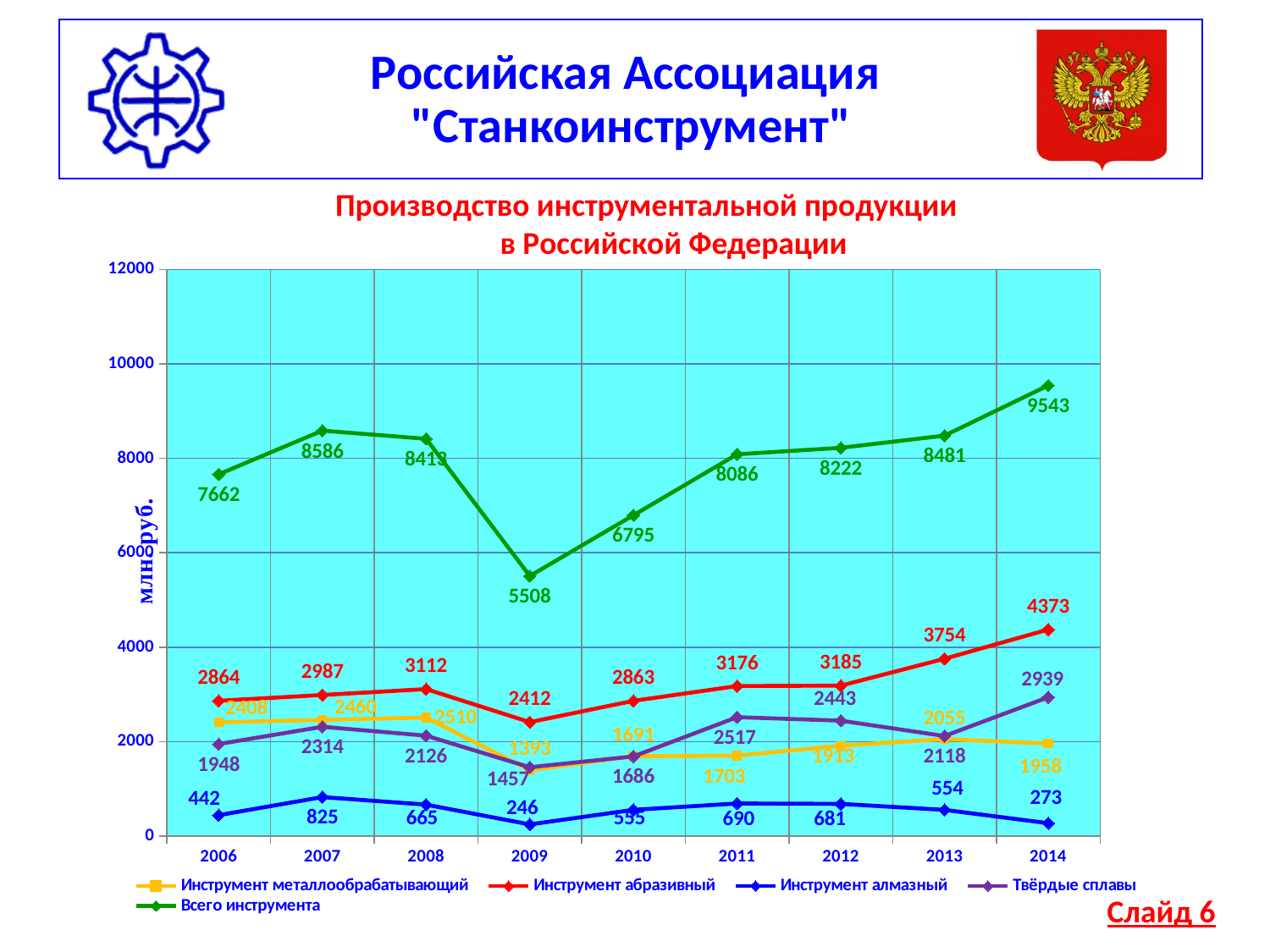
What kind of chart is shown on the slide? Line chart What unit is shown on the y axis? млн.руб. How many series does the legend list? 5 What was the value of Всего инструмента in 2014? 9543 In which year was Инструмент абразивный at its highest? 2014 What was the value of Твёрдые сплавы in 2011? 2517 What is the difference between Всего инструмента in 2014 and in 2006? 1881 What was the value of Инструмент абразивный in 2009? 2412 How many years are shown on the x axis? 9 Which was larger in 2012: Твёрдые сплавы or Инструмент металлообрабатывающий? Твёрдые сплавы In which year was Всего инструмента at its lowest? 2009 What was the value of Инструмент алмазный in 2007? 825